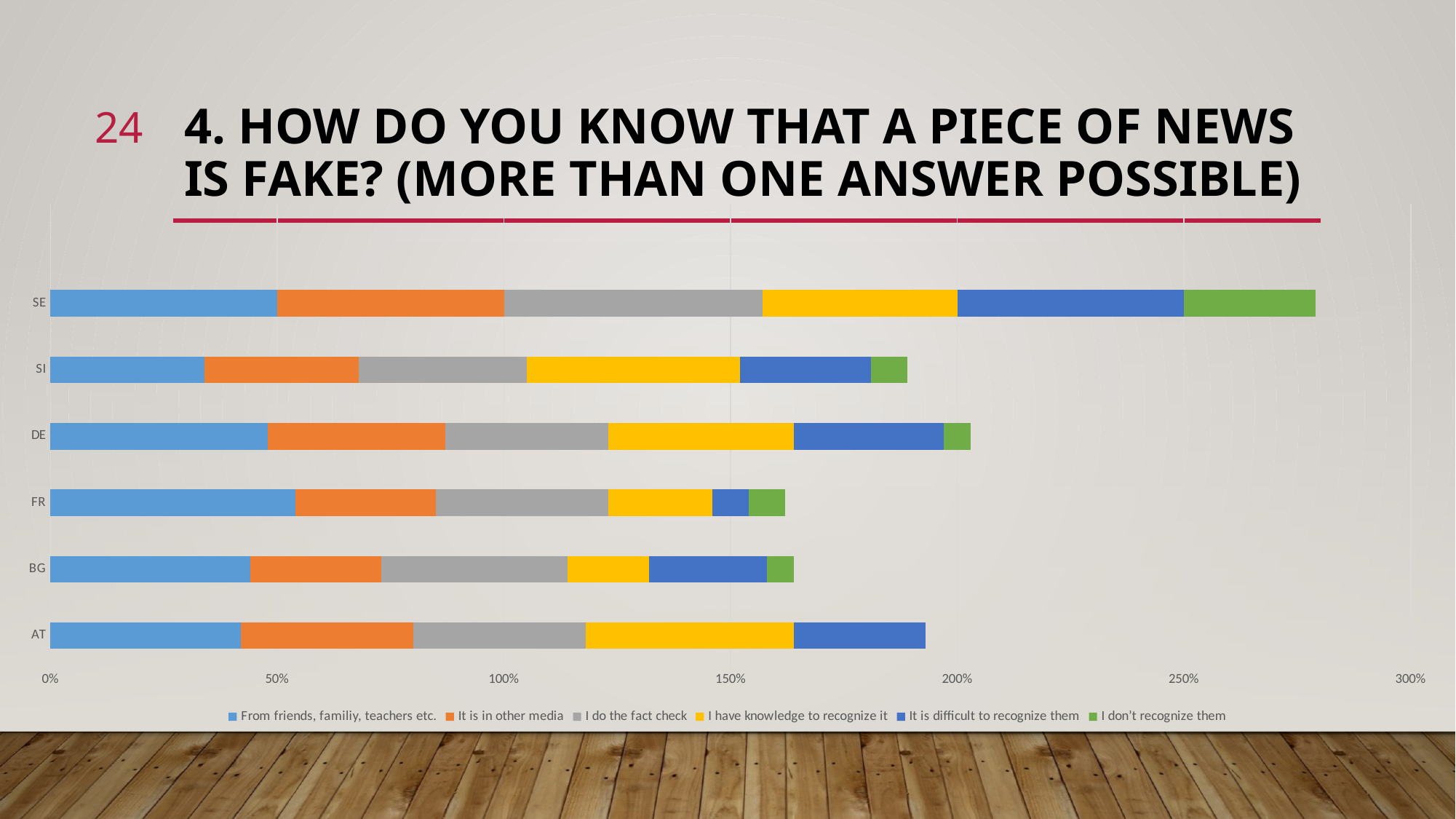
Which country has no 'I don't recognize them' segment in its bar? AT Which has the longer total bar, DE or FR? DE Is the 'From friends, familiy, teachers etc.' segment for SI greater or less than 50%? less Is the total bar for AT greater or less than 200%? less Which has the longer total bar, SE or SI? SE How many countries are shown on the chart? 6 Is the total bar for FR greater or less than 150%? greater What kind of chart is shown on the slide? Stacked bar chart How many series does the legend list? 6 Which country has the longest total bar? SE